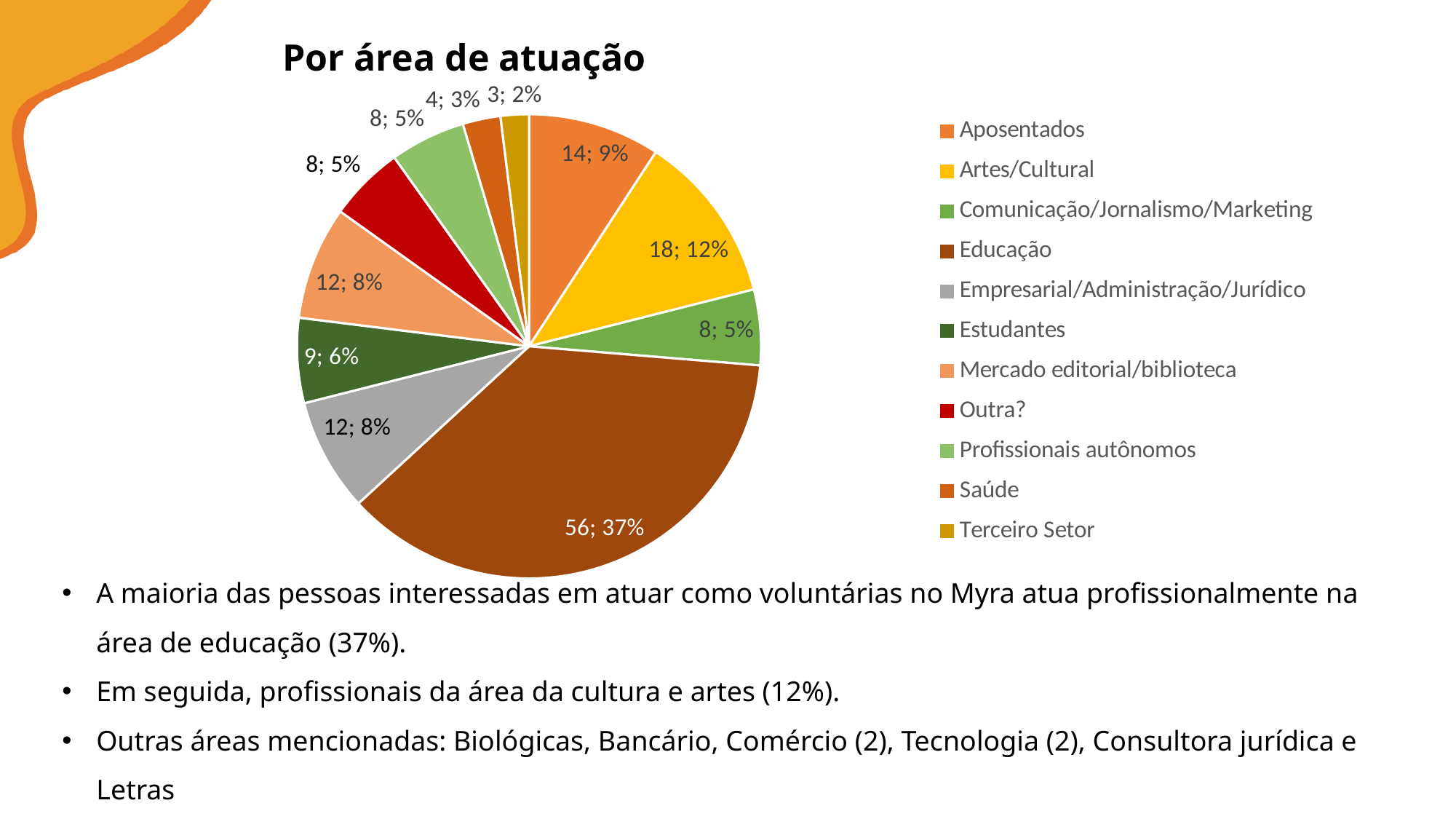
What is the title of the chart? Por área de atuação What kind of chart is shown on the slide? pie chart Which is larger, the slice for Aposentados or the slice for Saúde? Aposentados What is the value shown for Estudantes? 9; 6% What is the difference between the count for Educação and the count for Artes/Cultural? 38 What is the value shown for Artes/Cultural? 18; 12% How many categories does the legend list? 11 Which category has the largest slice? Educação What is the value shown for Aposentados? 14; 9% What share of the pie does Empresarial/Administração/Jurídico represent? 8% Which category has the smallest slice? Terceiro Setor What is the value shown for Educação? 56; 37%